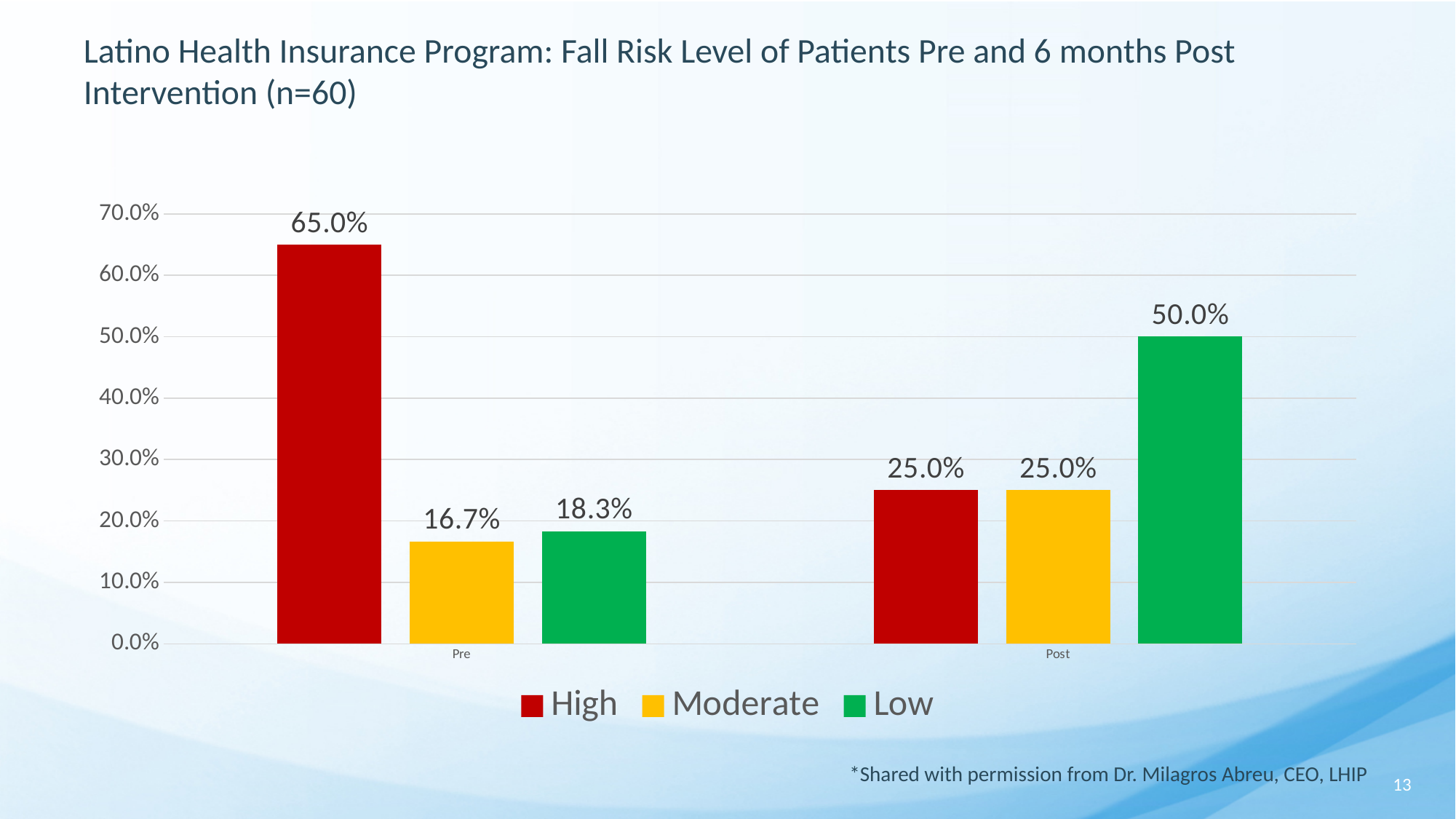
Which risk level has the highest value in the Pre group? High Which risk level has the lowest value in the Pre group? Moderate What is the difference between the High value in the Pre group and the High value in the Post group? 40.0% How many series does the legend list? 3 Which is larger: the Low value in the Pre group or the Low value in the Post group? Post What is the value for Moderate fall risk in the Pre group? 16.7% How many categories are shown on the x axis? 2 What is the value for Low fall risk in the Pre group? 18.3% What kind of chart is shown on the slide? Bar chart What colour represents the Moderate series? Yellow What is the value for High fall risk in the Pre group? 65.0% What is the value for Low fall risk in the Post group? 50.0%